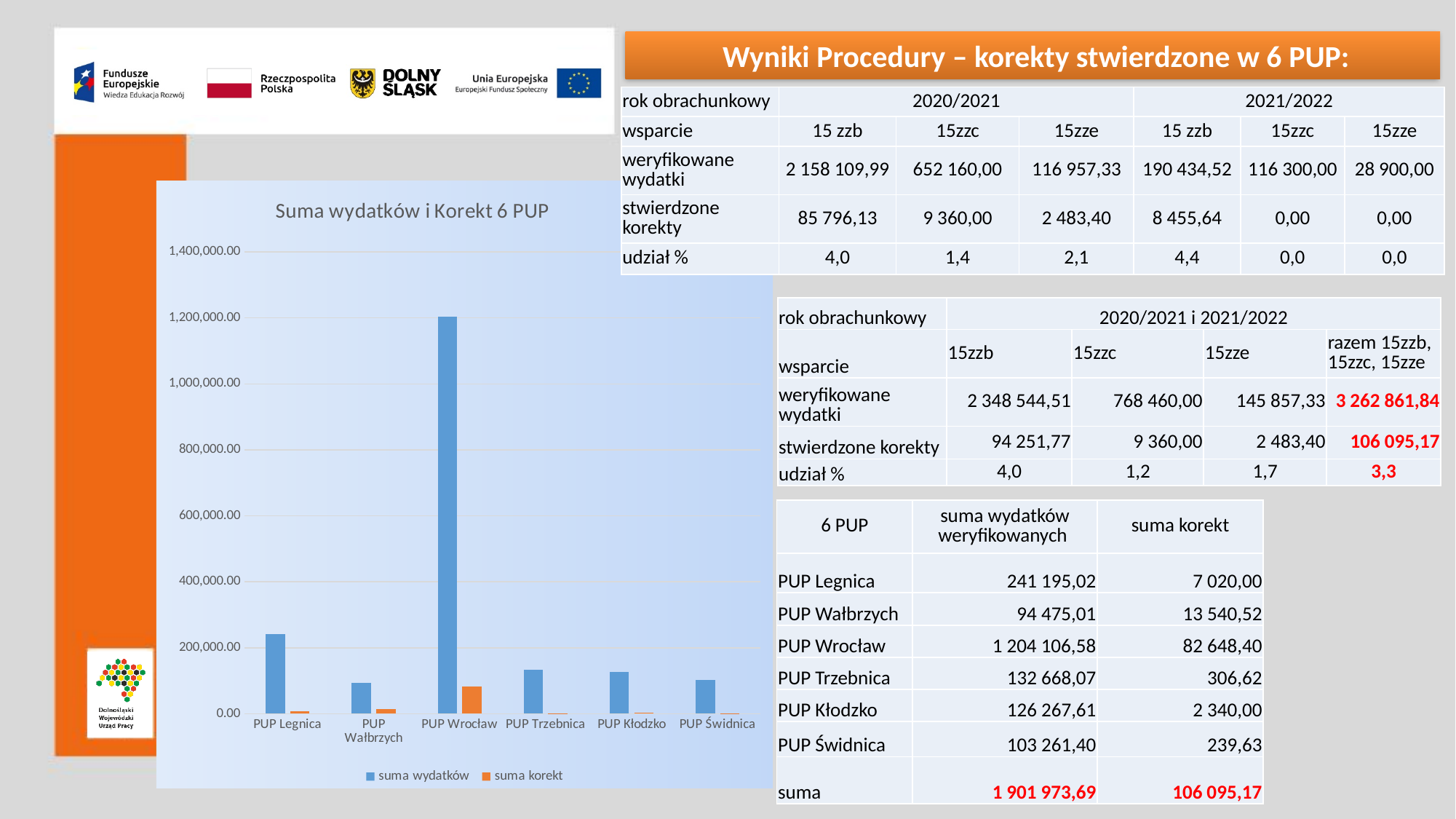
Is the suma wydatków value for PUP Wałbrzych greater or less than 200,000.00? less Which PUP has the highest suma wydatków bar in the chart? PUP Wrocław Is the suma wydatków value for PUP Wrocław greater or less than 1,000,000.00? greater How many series does the chart legend list? 2 How many PUP categories are shown on the x axis of the chart? 6 Is the suma korekt value for PUP Wrocław greater or less than 200,000.00? less What kind of chart is "Suma wydatków i Korekt 6 PUP"? bar chart Which PUP has the highest suma korekt bar in the chart? PUP Wrocław Which is larger in the chart: suma wydatków for PUP Legnica or for PUP Trzebnica? PUP Legnica Which colour represents the suma korekt series in the chart? orange What is the title of the chart on the slide? Suma wydatków i Korekt 6 PUP